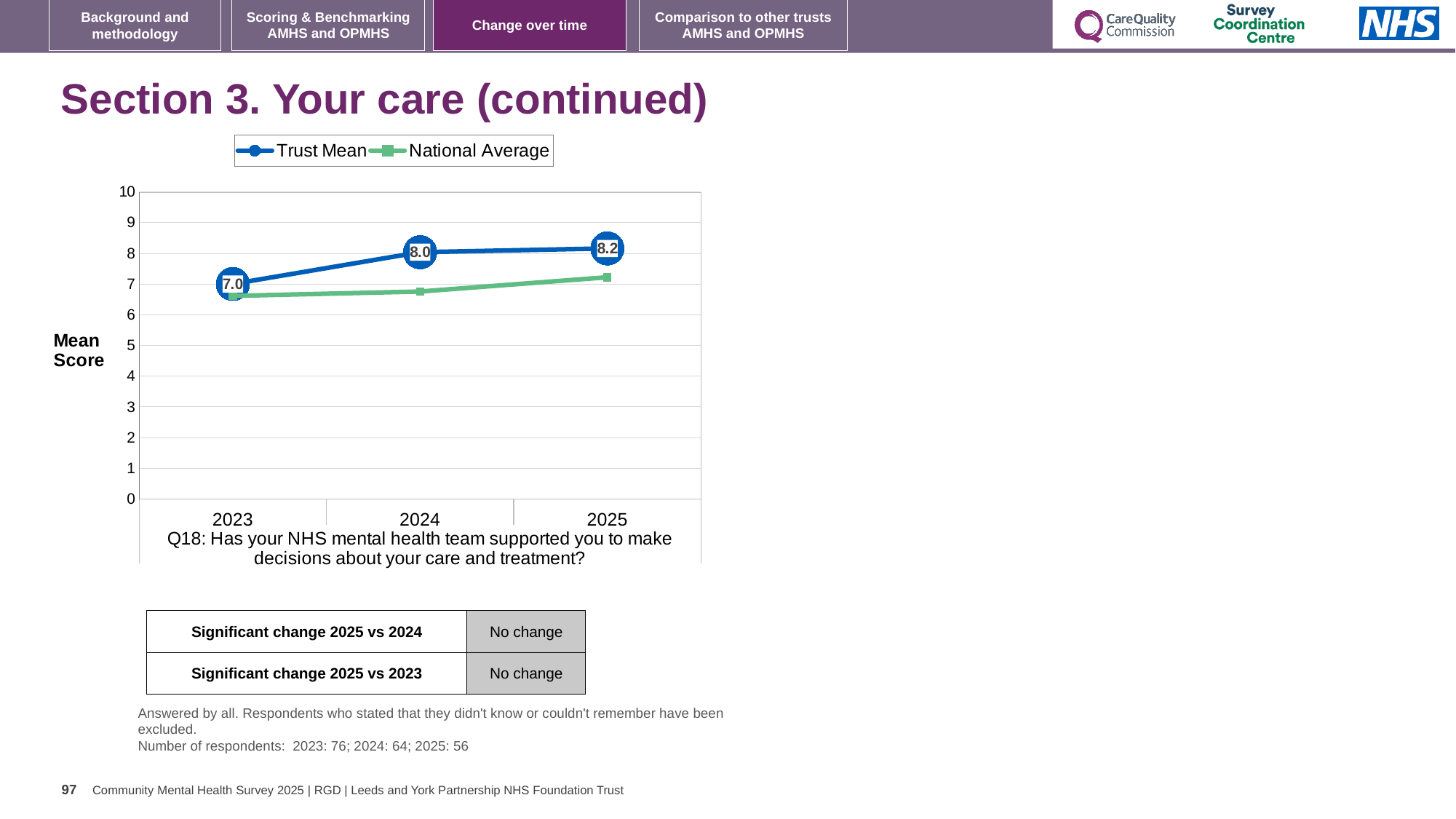
In which year is the Trust Mean highest? 2025 In which year is the Trust Mean lowest? 2023 What kind of chart is shown? line chart What is the difference between the Trust Mean in 2025 and in 2023? 1.2 Which is larger, the Trust Mean in 2024 or in 2023? 2024 What is the Trust Mean score for 2025? 8.2 How many years are shown on the x axis? 3 What is the Trust Mean score for 2023? 7.0 What is the Trust Mean score for 2024? 8.0 Is the National Average for 2025 greater or less than 8? less How many series does the legend list? 2 Is the National Average for 2023 greater or less than 7? less